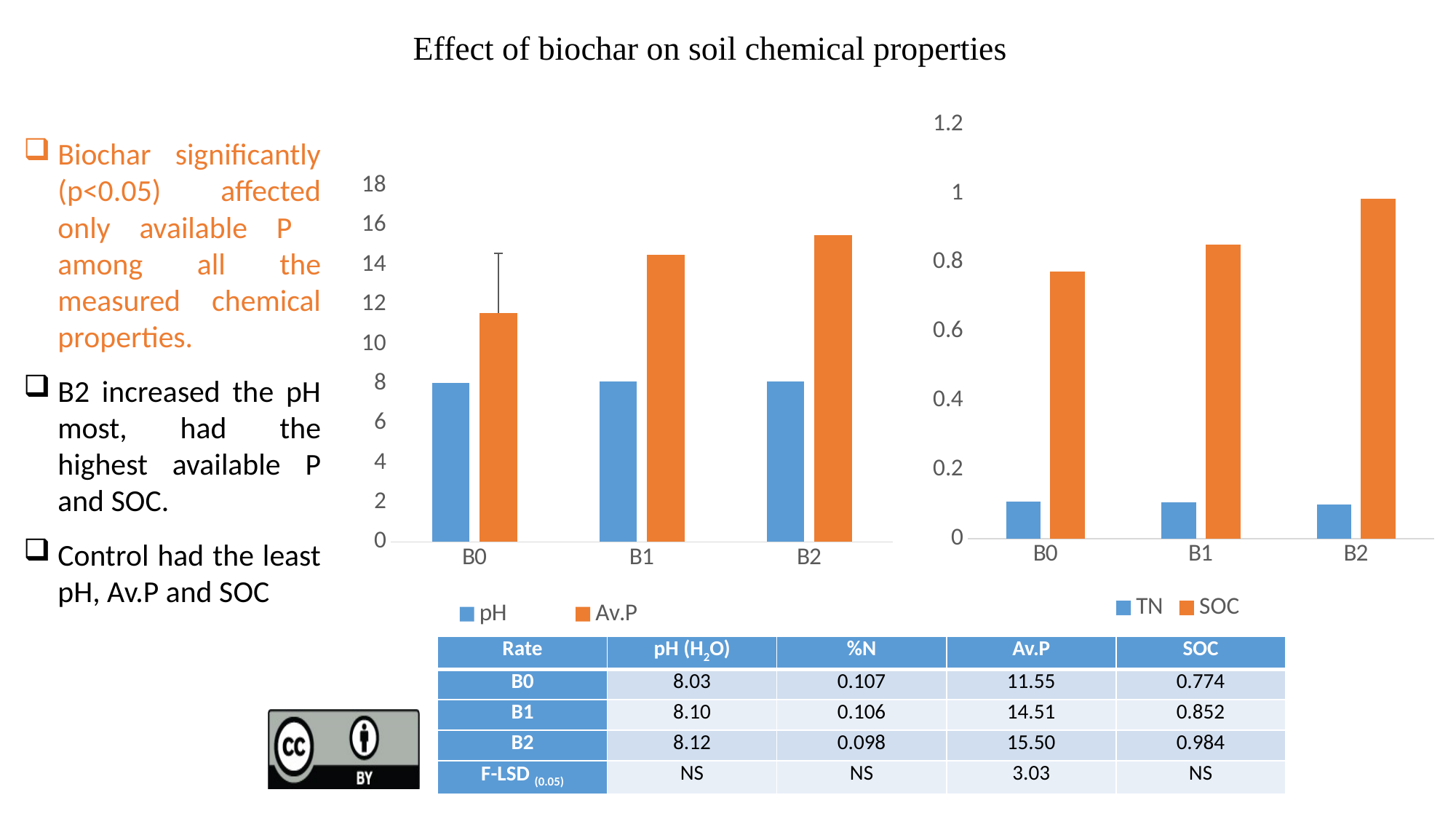
What type of chart is the left chart showing pH and Av.P? bar chart In the left chart, is the Av.P value for B2 greater or less than 16? less In the right chart, is the SOC value for B1 greater or less than 0.8? greater In the left chart (pH and Av.P), how many series does the legend list? 2 In the right chart (TN and SOC), how many categories are shown on the x axis? 3 In the right chart, do the SOC values rise or fall from B0 to B2? rise In the left chart, which category has the lowest Av.P bar? B0 In the right chart, is the TN value for B0 greater or less than 0.2? less In the left chart, which category has the highest Av.P bar? B2 In the right chart, which category has the highest SOC bar? B2 In the right chart, which series is shown in orange? SOC